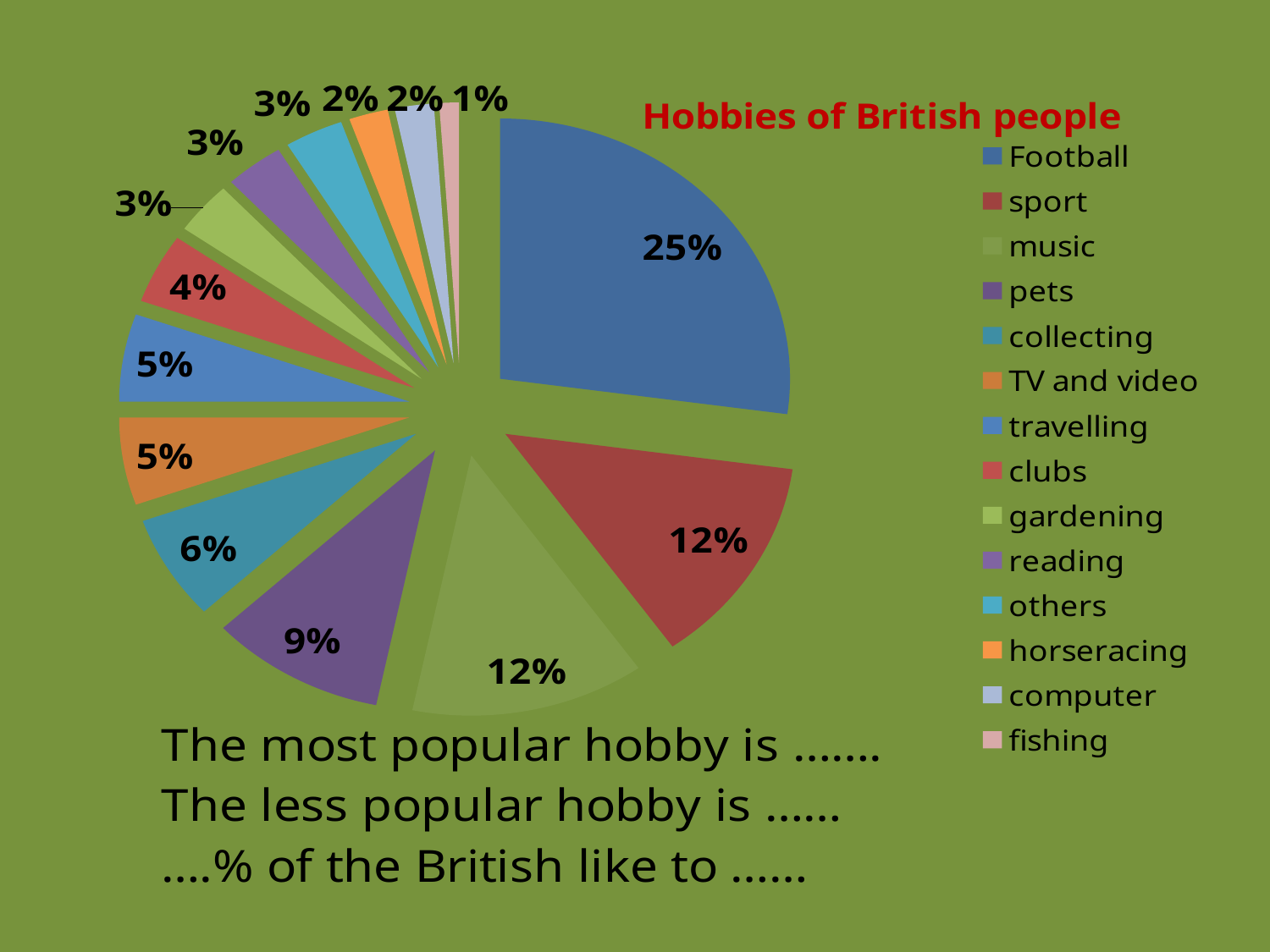
Which hobby has the largest share of the pie? Football Which hobby has the smallest share of the pie? fishing What kind of chart is shown on the slide? pie chart What percentage of the pie is pets? 9% What percentage of the pie is Football? 25% What is the difference in percentage points between Football and sport? 13 What percentage of the pie is collecting? 6% What share of the pie does fishing take? 1% How many hobby categories does the legend list? 14 What percentage of the pie is clubs? 4% Which is larger, the share for pets or the share for collecting? pets What is the title of the chart? Hobbies of British people